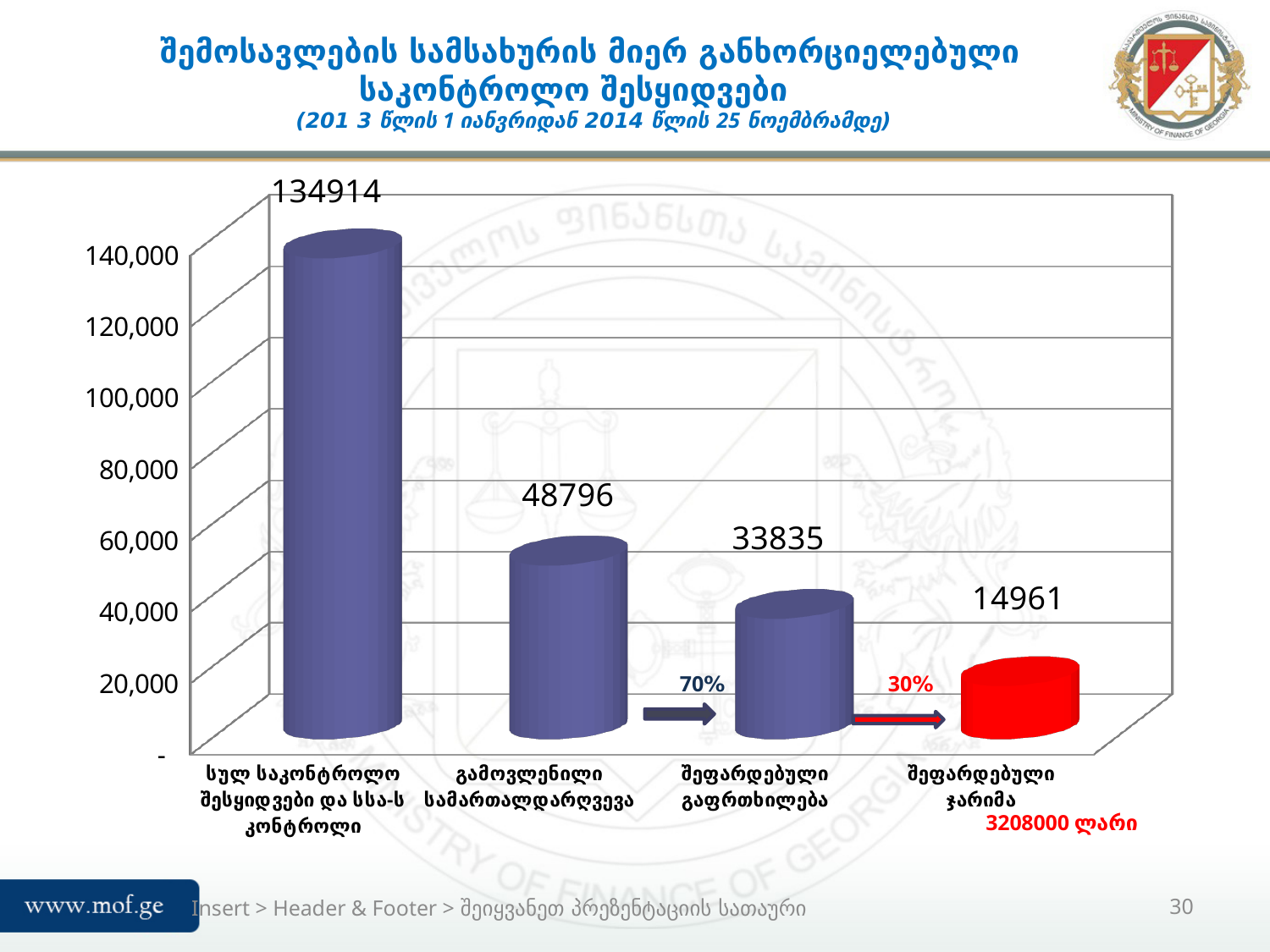
How many categories are shown in the chart? 4 Which category has the lowest value? შეფარდებული ჯარიმა Which category has the highest value? სულ საკონტროლო შესყიდვები და სსა-ს კონტროლი What percentage label is shown on the arrow pointing to the "შეფარდებული ჯარიმა" bar? 30% Which is larger, the value for "გამოვლენილი სამართალდარღვევა" or the value for "შეფარდებული ჯარიმა"? გამოვლენილი სამართალდარღვევა What is the value for "შეფარდებული ჯარიმა"? 14961 What kind of chart is shown on the slide? Bar chart What is the difference between the values for "გამოვლენილი სამართალდარღვევა" and "შეფარდებული გაფრთხილება"? 14961 What is the value for "სულ საკონტროლო შესყიდვები და სსა-ს კონტროლი"? 134914 What is the difference between the values for "შეფარდებული გაფრთხილება" and "შეფარდებული ჯარიმა"? 18874 What is the value for "შეფარდებული გაფრთხილება"? 33835 What is the value for "გამოვლენილი სამართალდარღვევა"? 48796